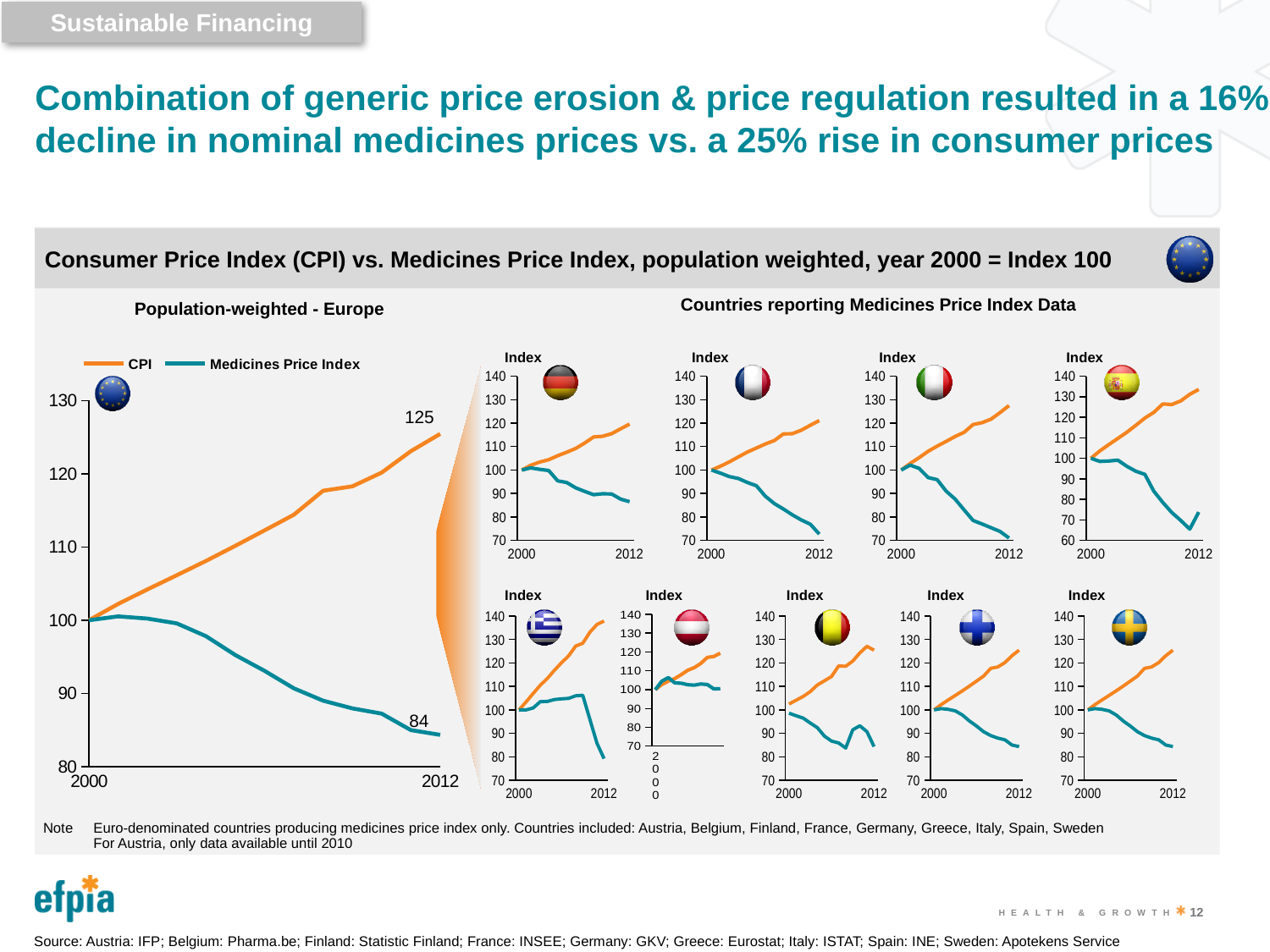
In the fourth small chart of the top row under 'Countries reporting Medicines Price Index Data', is the CPI value in 2012 greater or less than 120? greater What kind of chart is the Population-weighted - Europe chart? Line chart In the Population-weighted - Europe chart, what is the value of the Medicines Price Index in 2012? 84 How many small country charts are shown under 'Countries reporting Medicines Price Index Data'? 9 How many series does the legend of the Population-weighted - Europe chart list? 2 In the Population-weighted - Europe chart, does the CPI rise or fall from 2000 to 2012? Rise In the Population-weighted - Europe chart, what is the difference between the CPI and the Medicines Price Index in 2012? 41 In the Population-weighted - Europe chart, which series is higher in 2012, CPI or Medicines Price Index? CPI In the Population-weighted - Europe chart, what is the value of the CPI in 2012? 125 In the first small chart of the top row under 'Countries reporting Medicines Price Index Data', is the Medicines Price Index value in 2012 greater or less than 100? less In the Population-weighted - Europe chart, what colour is the CPI line? Orange In the Population-weighted - Europe chart, does the Medicines Price Index rise or fall from 2000 to 2012? Fall